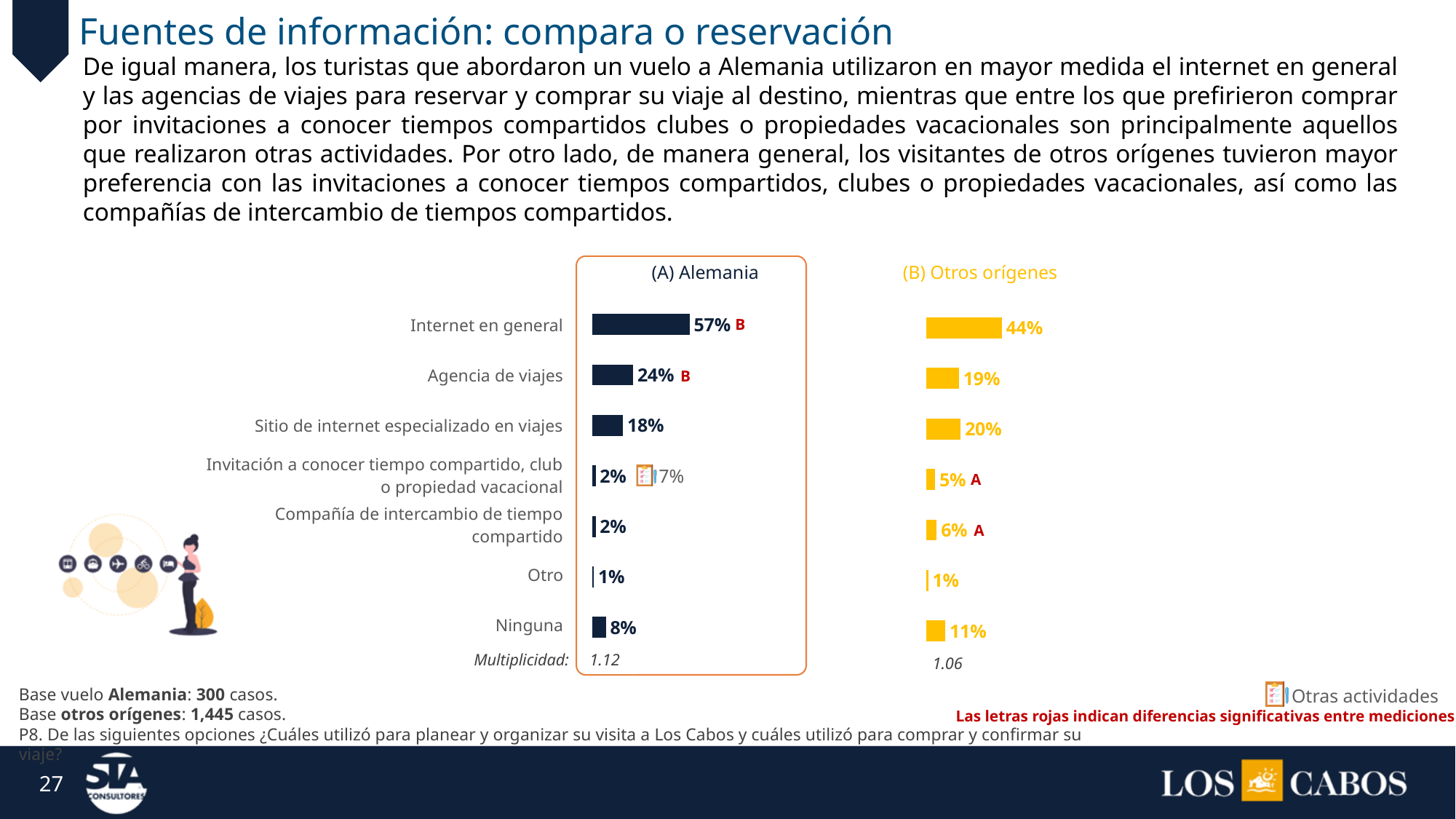
In the (B) Otros orígenes chart, what is the value for Ninguna? 11% What is the Multiplicidad value shown under the (A) Alemania chart? 1.12 In the (B) Otros orígenes chart, what is the value for Agencia de viajes? 19% In the (A) Alemania chart, what is the value for Internet en general? 57% In the (A) Alemania chart, what is the difference between Agencia de viajes and Ninguna? 16 percentage points What is the difference between the Internet en general values in the (A) Alemania chart and the (B) Otros orígenes chart? 13 percentage points In the (B) Otros orígenes chart, which category has the lowest value? Otro In the (A) Alemania chart, which category has the highest value? Internet en general For Sitio de internet especializado en viajes, which chart shows the larger value, (A) Alemania or (B) Otros orígenes? (B) Otros orígenes How many categories are shown in the (A) Alemania chart? 7 In the (A) Alemania chart, what is the value for Sitio de internet especializado en viajes? 18% What kind of chart is the (B) Otros orígenes chart? Bar chart